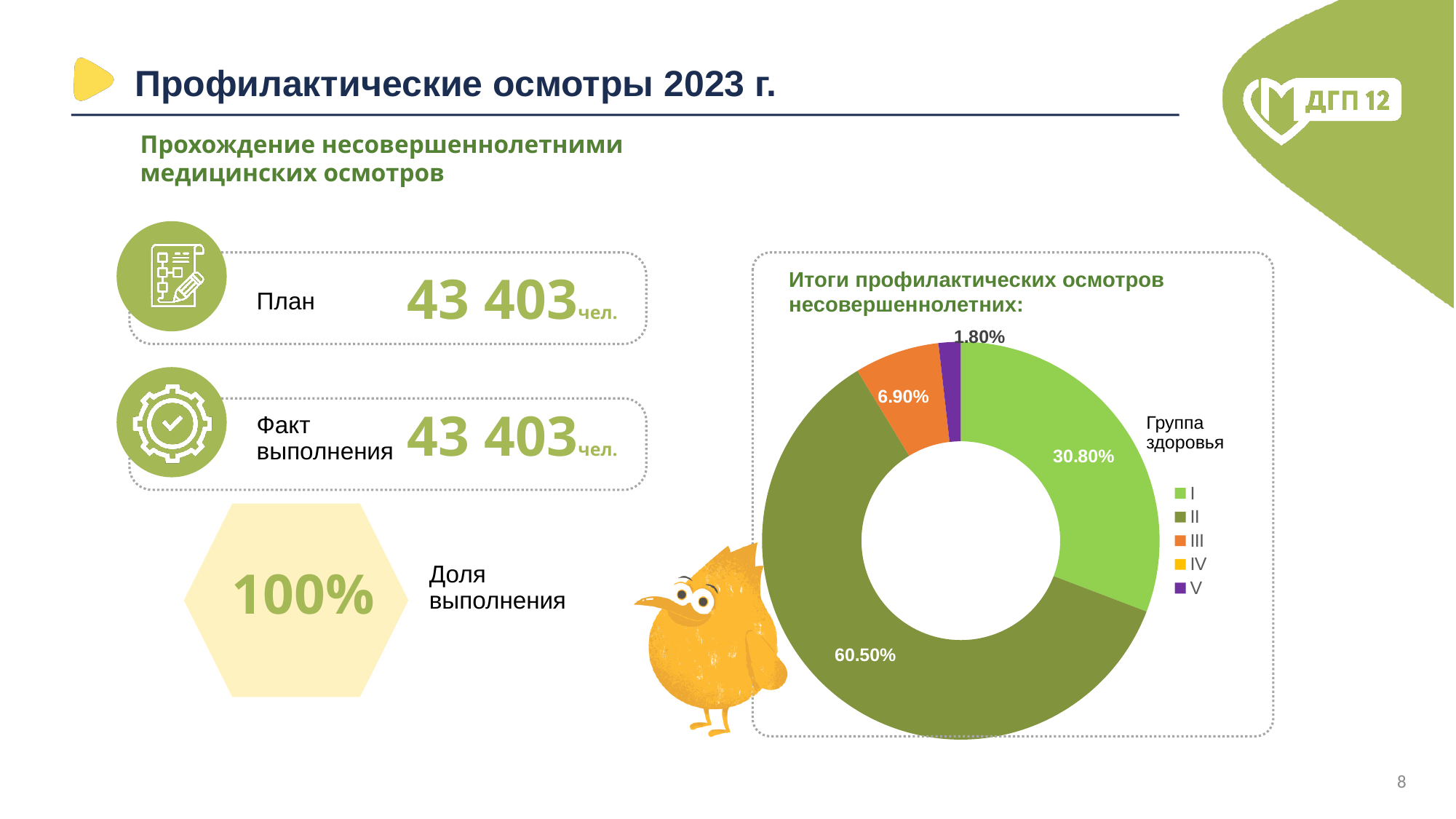
What is the combined share of health groups I and II in the doughnut chart? 91.30% Among the labelled slices of the doughnut chart, which health group has the smallest share? V Which health group has the largest share in the doughnut chart? II By how many percentage points does the share of health group II exceed that of health group I? 29.70 What percentage of the doughnut chart corresponds to health group V? 1.80% How many health groups are listed in the legend of the doughnut chart? 5 What colour represents health group III in the doughnut chart? orange What percentage of the doughnut chart corresponds to health group I? 30.80% What percentage of the doughnut chart corresponds to health group II? 60.50% What type of chart is used to show the results of the preventive examinations? doughnut chart What percentage of the doughnut chart corresponds to health group III? 6.90% Which has a larger share in the doughnut chart, health group III or health group V? III